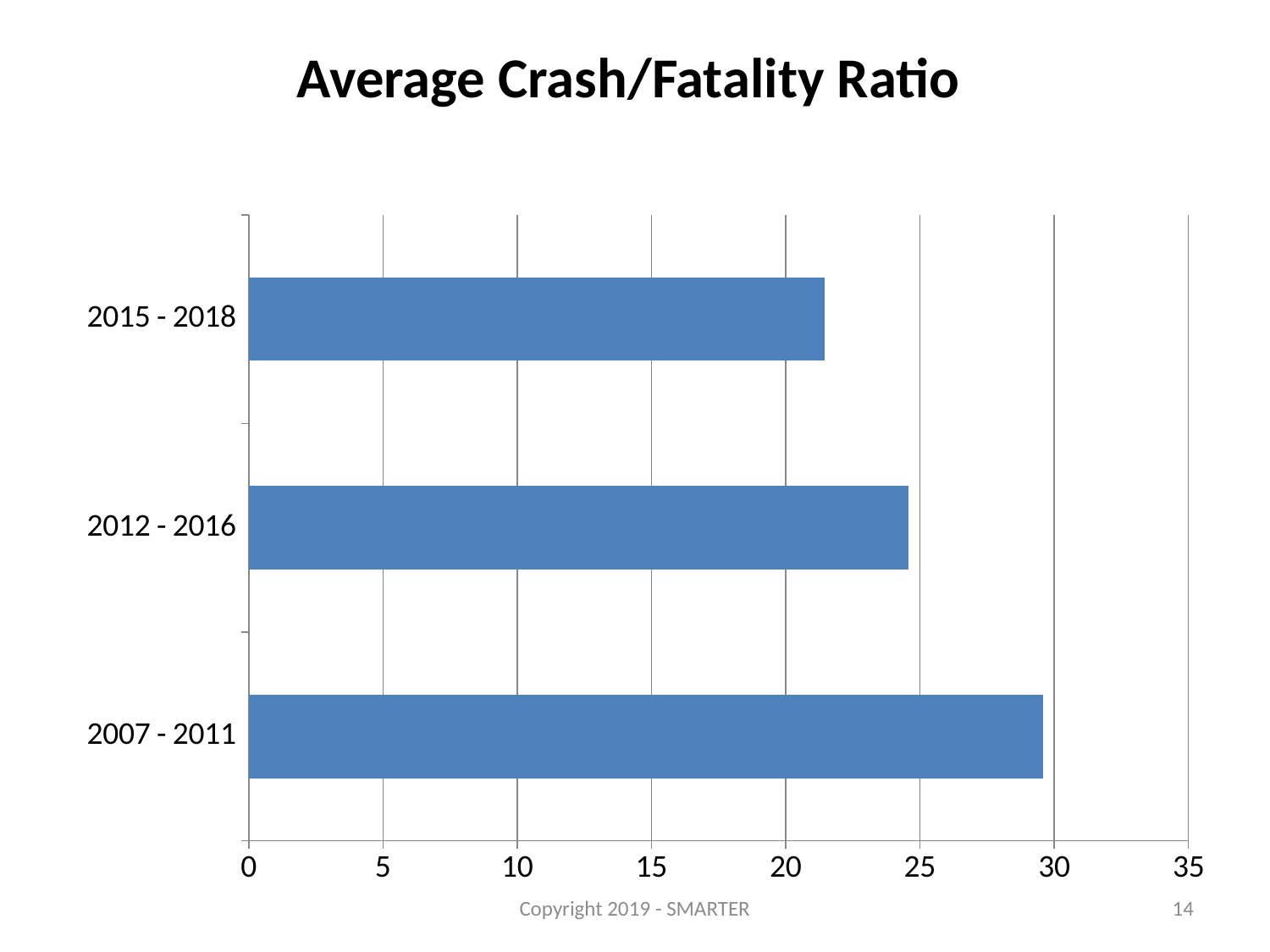
Which time period has the highest average crash/fatality ratio? 2007 - 2011 Which has a larger average crash/fatality ratio, 2012 - 2016 or 2015 - 2018? 2012 - 2016 What is the title of the chart? Average Crash/Fatality Ratio Is the value for 2015 - 2018 greater or less than 25? less What kind of chart is shown on the slide? bar chart How many categories (time periods) are plotted in the chart? 3 Which time period has the lowest average crash/fatality ratio? 2015 - 2018 What is the maximum value shown on the horizontal axis? 35 Is the value for 2012 - 2016 greater or less than 20? greater Which has a larger average crash/fatality ratio, 2007 - 2011 or 2012 - 2016? 2007 - 2011 Is the value for 2007 - 2011 greater or less than 25? greater